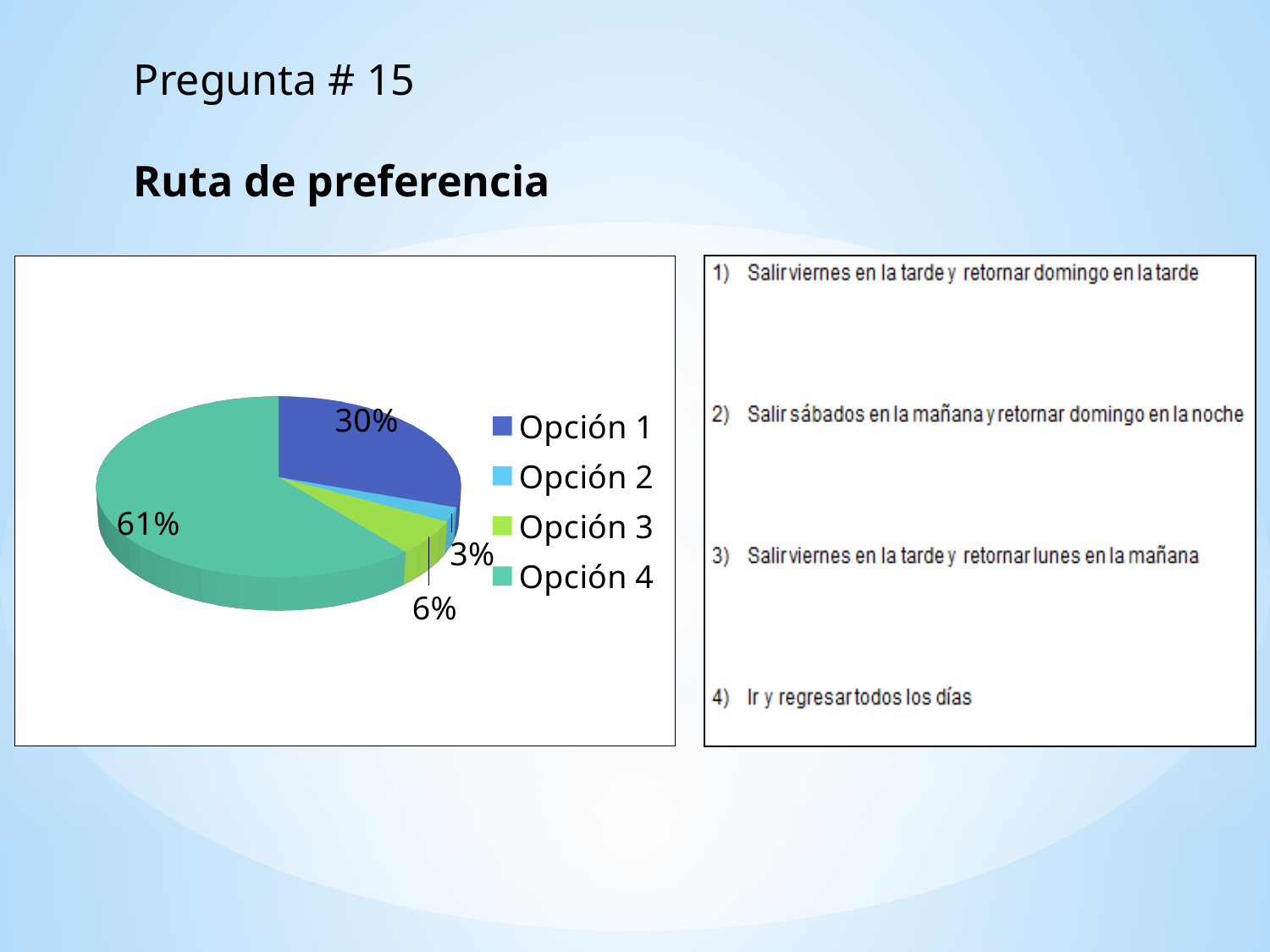
What share of the pie does Opción 2 have? 3% What share of the pie does Opción 1 have? 30% What share of the pie does Opción 3 have? 6% Which option has the smallest slice of the pie? Opción 2 What is the difference in percentage points between Opción 4 and Opción 1? 31% What is the title of the slide above the chart? Ruta de preferencia Which option has the largest slice of the pie? Opción 4 What kind of chart is shown on the slide? pie chart How many slices does the pie chart have? 4 How many entries does the legend list? 4 Which is larger, the slice for Opción 3 or the slice for Opción 2? Opción 3